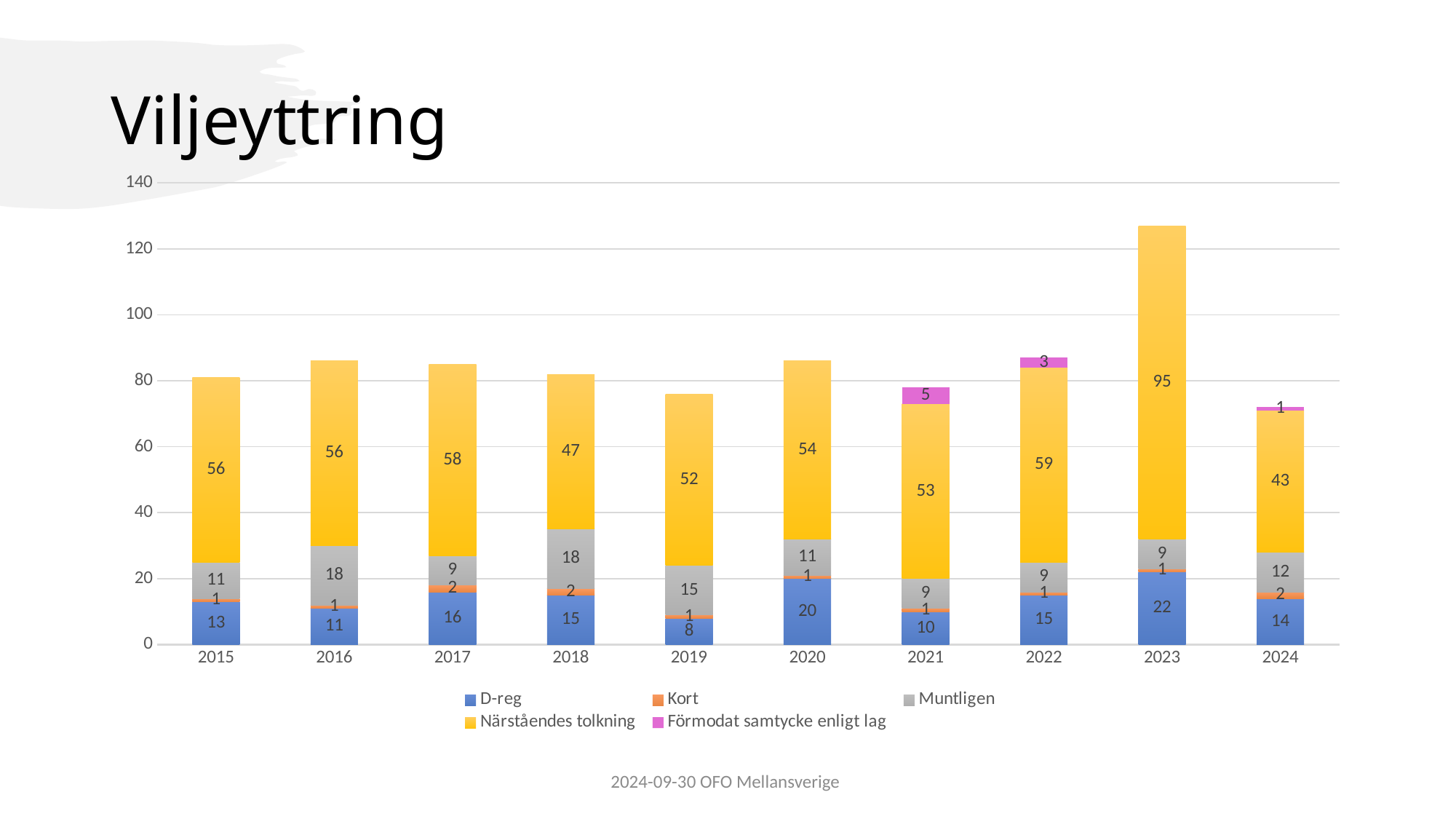
What is the total of the stacked bar for 2023? 127 What is the value of Förmodat samtycke enligt lag for 2021? 5 What is the value of Närståendes tolkning for 2023? 95 What is the difference between the Närståendes tolkning values for 2023 and 2024? 52 How many series does the legend list? 5 What is the D-reg value for 2020? 20 What is the Muntligen value for 2018? 18 What is the total of the stacked bar for 2015? 81 Which year has the larger Muntligen value, 2016 or 2017? 2016 How many years are shown on the x axis? 10 Which year has the highest value for Närståendes tolkning? 2023 Which year has the lowest D-reg value? 2019